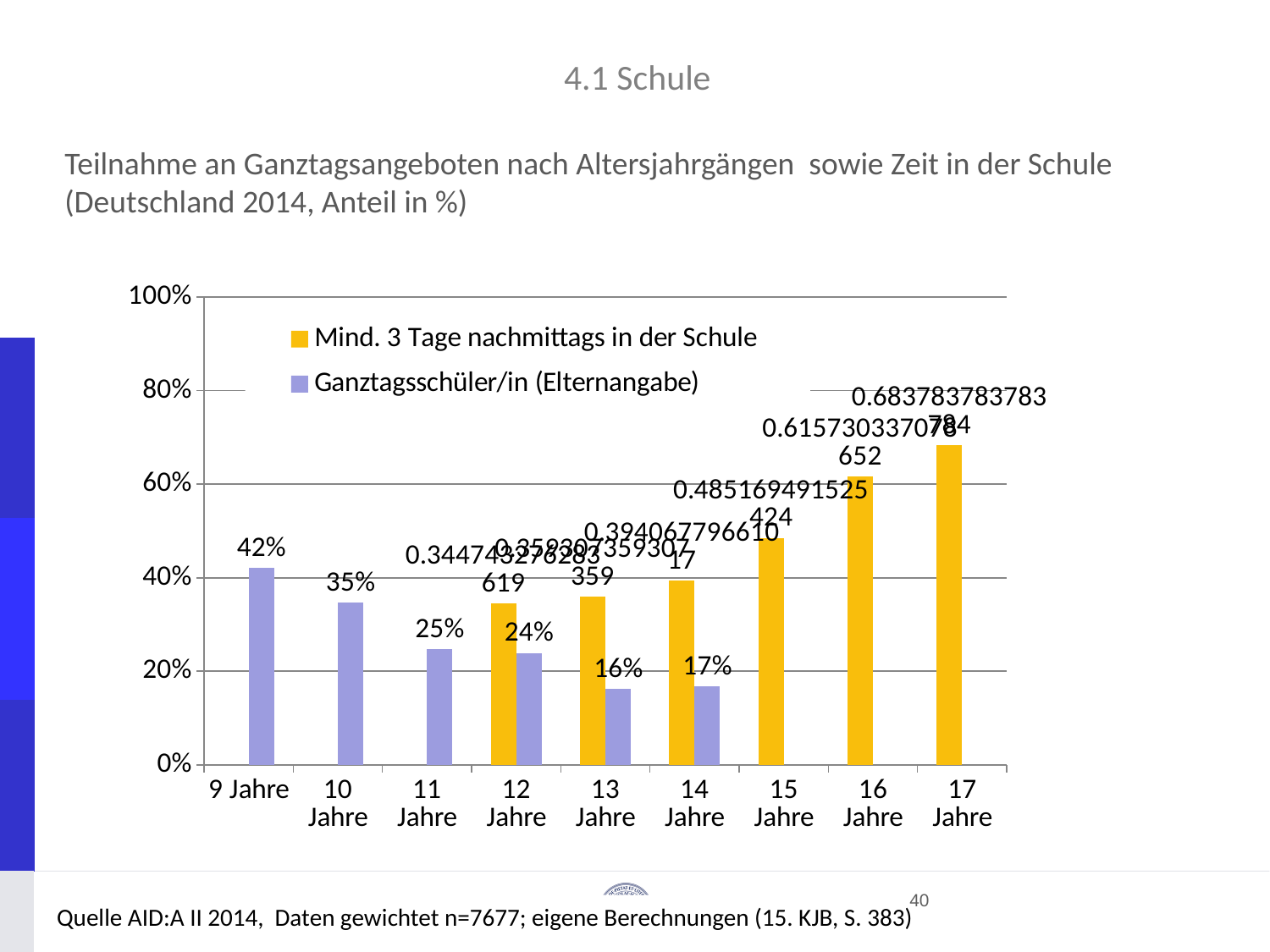
How many series does the legend list? 2 What is the value for 13 Jahre in the Ganztagsschüler/in (Elternangabe) series? 16% What is the value for 9 Jahre in the Ganztagsschüler/in (Elternangabe) series? 42% Is the value for 17 Jahre in the Mind. 3 Tage nachmittags in der Schule series greater or less than 60%? greater Do the values of the Mind. 3 Tage nachmittags in der Schule series rise or fall from 12 Jahre to 17 Jahre? rise In the Ganztagsschüler/in (Elternangabe) series, which is larger: 11 Jahre or 12 Jahre? 11 Jahre Is the value for 15 Jahre in the Mind. 3 Tage nachmittags in der Schule series greater or less than 40%? greater What kind of chart is shown on the slide? bar chart Which age group has the highest value in the Mind. 3 Tage nachmittags in der Schule series? 17 Jahre What is the difference between the Ganztagsschüler/in (Elternangabe) values for 9 Jahre and 10 Jahre? 7 percentage points How many age groups are shown on the x axis? 9 Which age group has the highest value in the Ganztagsschüler/in (Elternangabe) series? 9 Jahre